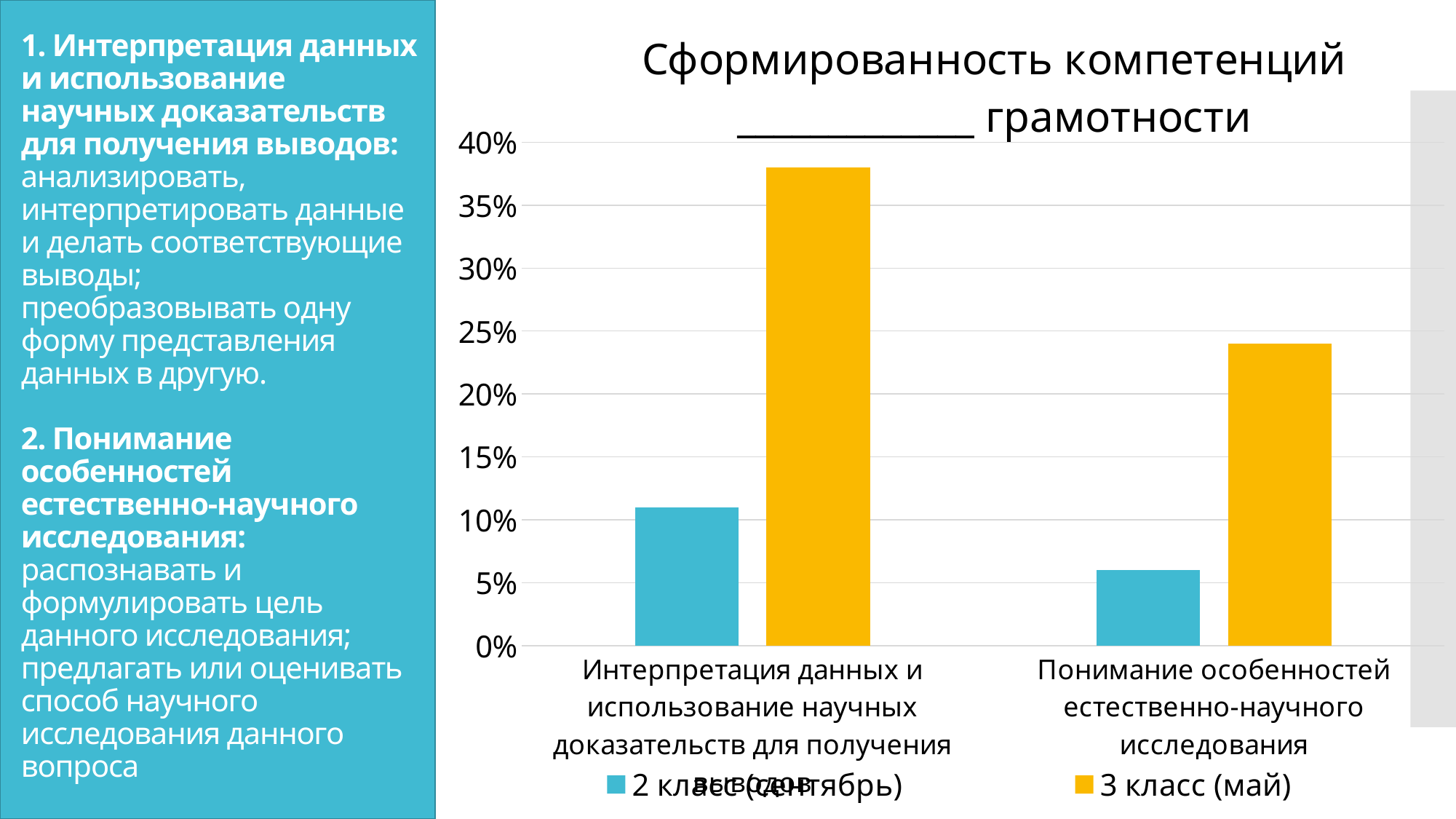
How many series does the legend list? 2 What kind of chart is shown on the slide? bar chart What colour are the bars for the series 3 класс (май)? orange Is the value for 2 класс (сентябрь) in the category Интерпретация данных и использование научных доказательств для получения выводов greater or less than 15%? less Is the value for 2 класс (сентябрь) in the category Понимание особенностей естественно-научного исследования greater or less than 10%? less Which series has the highest bar on the chart? 3 класс (май) Which bar is the lowest on the chart? 2 класс (сентябрь) for Понимание особенностей естественно-научного исследования Is the value for 3 класс (май) in the category Интерпретация данных и использование научных доказательств для получения выводов greater or less than 35%? greater How many categories are shown on the x axis? 2 Which category has the higher value for 3 класс (май)? Интерпретация данных и использование научных доказательств для получения выводов For the category Понимание особенностей естественно-научного исследования, which series has the larger value: 2 класс (сентябрь) or 3 класс (май)? 3 класс (май)